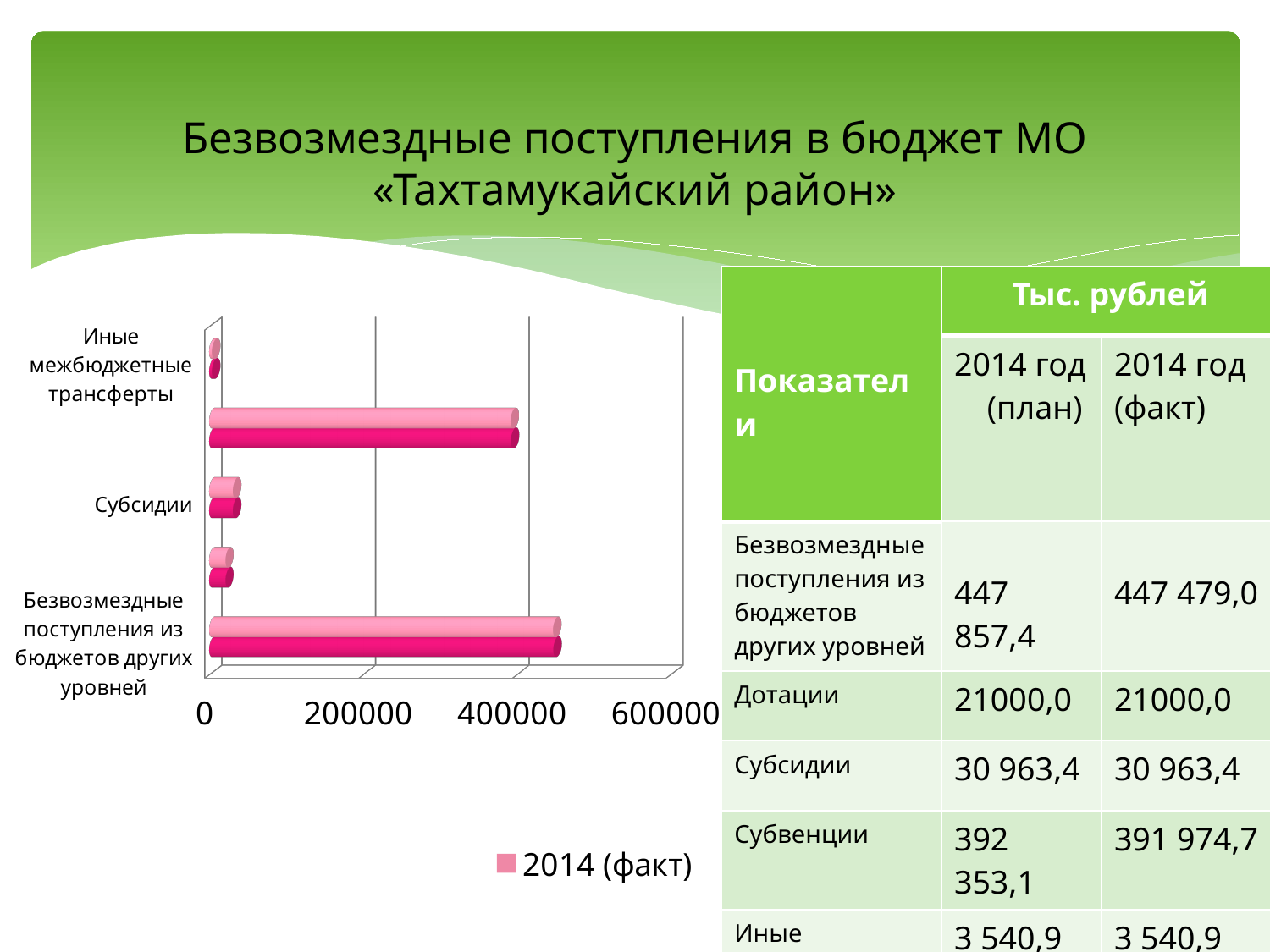
Is the value for Субсидии greater or less than 200000? less Which category has the shortest bars in the chart? Иные межбюджетные трансферты What is the highest tick value shown on the horizontal axis of the chart? 600000 What kind of chart is shown on the slide? bar chart Which category has the longest bars in the chart? Безвозмездные поступления из бюджетов других уровней Which is larger in the chart, the value for Субсидии or the value for Иные межбюджетные трансферты? Субсидии Is the value for Безвозмездные поступления из бюджетов других уровней greater or less than 600000? less Is the value for Безвозмездные поступления из бюджетов других уровней greater or less than 400000? greater How many category groups of bars are plotted in the chart? 5 What is the title of the slide containing the chart? Безвозмездные поступления в бюджет МО «Тахтамукайский район»